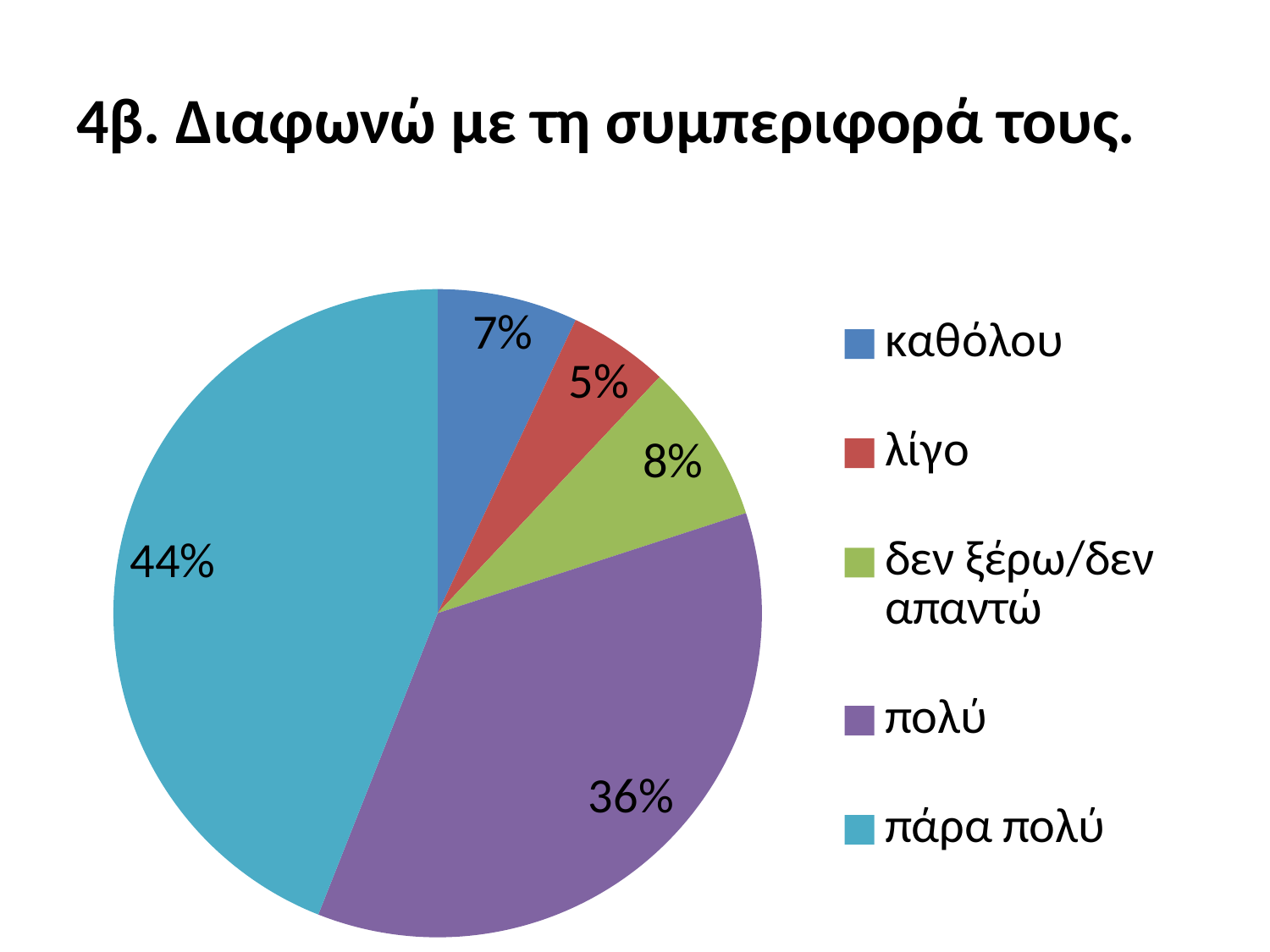
What is the value for καθόλου? 7% What is the title of the slide? 4β. Διαφωνώ με τη συμπεριφορά τους. How many categories does the pie chart have? 5 What is the value for πολύ? 36% What is the value for λίγο? 5% What is the value for πάρα πολύ? 44% Which category has the largest share of the pie? πάρα πολύ Which is larger, the value for καθόλου or the value for δεν ξέρω/δεν απαντώ? δεν ξέρω/δεν απαντώ What is the difference between the values for πάρα πολύ and πολύ? 8% What is the value for δεν ξέρω/δεν απαντώ? 8% Which category has the smallest share of the pie? λίγο What type of chart is shown on the slide? pie chart